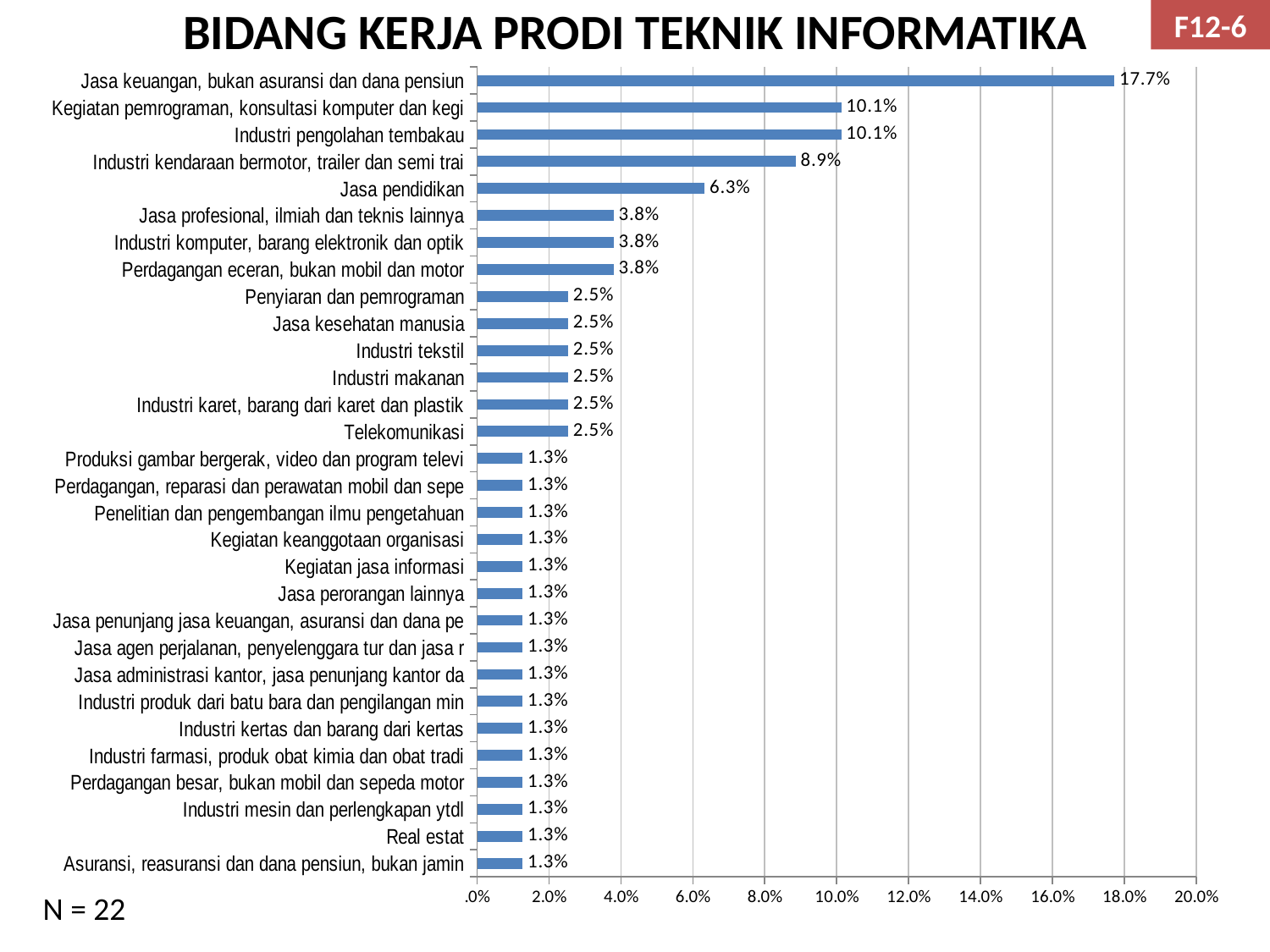
What is the value for Real estat? 1.3% How many categories are shown in the chart? 30 Which category has the highest value? Jasa keuangan, bukan asuransi dan dana pensiun What is the difference between the values for Jasa keuangan, bukan asuransi dan dana pensiun and Jasa pendidikan? 11.4% Is the value for Jasa keuangan, bukan asuransi dan dana pensiun greater or less than 16.0%? greater Which is larger, the value for Jasa pendidikan or the value for Industri komputer, barang elektronik dan optik? Jasa pendidikan What is the value for Jasa pendidikan? 6.3% What kind of chart is shown on the slide? bar chart What is the title of the chart? BIDANG KERJA PRODI TEKNIK INFORMATIKA What is the value for Telekomunikasi? 2.5% What is the value for Industri pengolahan tembakau? 10.1% What is the difference between the values for Industri kendaraan bermotor, trailer dan semi trai and Industri tekstil? 6.4%